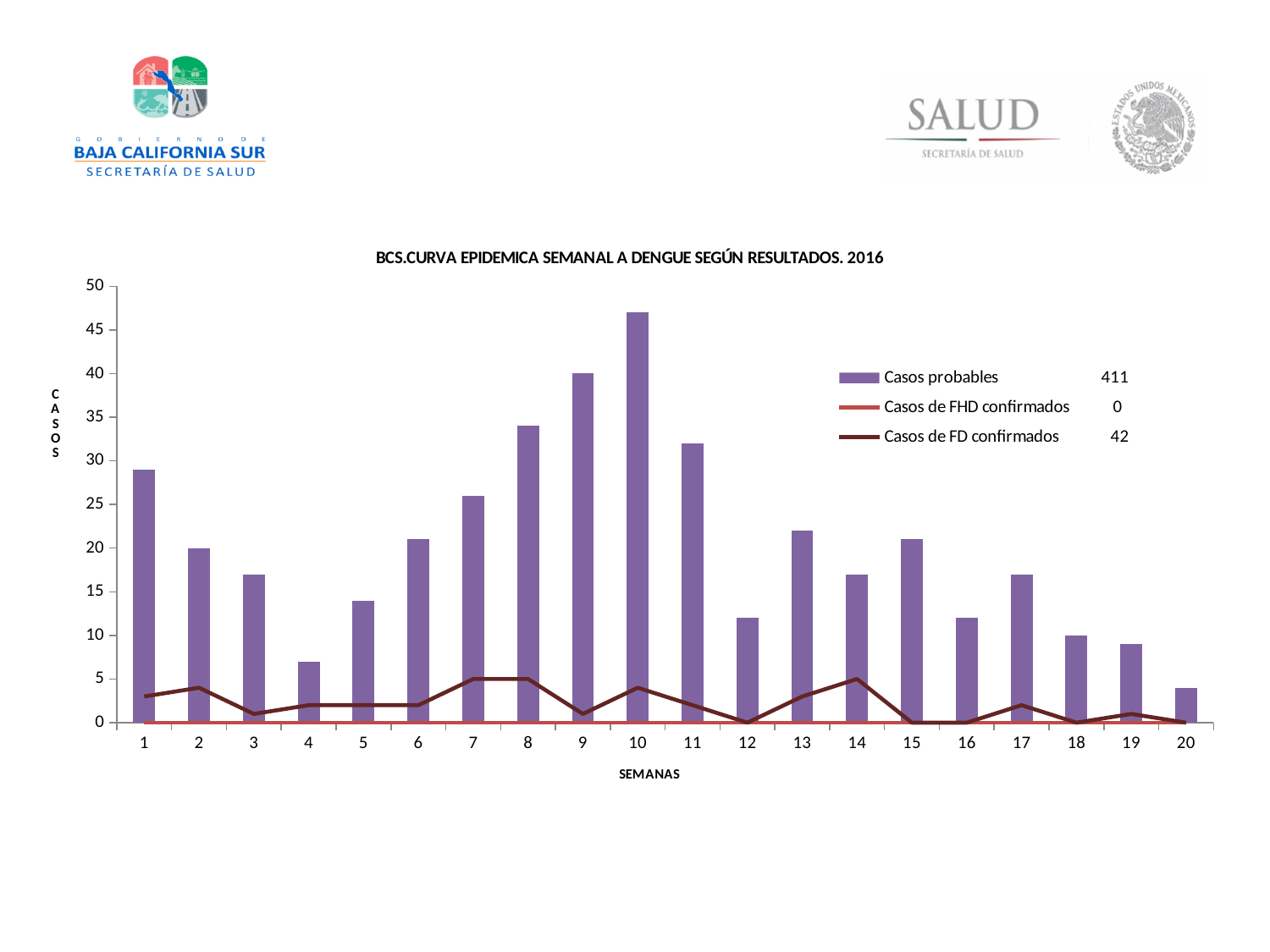
What total is shown in the legend for Casos de FHD confirmados? 0 How many series does the legend list? 3 How many weeks (semanas) are shown on the x axis? 20 In which week is the Casos probables bar lowest? 20 Which week has more Casos probables, week 9 or week 11? 9 In which week is the Casos probables bar highest? 10 What total is shown in the legend for Casos de FD confirmados? 42 Is the Casos probables value for week 1 greater or less than 30? less What is the title of the chart? BCS.CURVA EPIDEMICA SEMANAL A DENGUE SEGÚN RESULTADOS. 2016 Is the Casos probables value for week 10 greater or less than 45? greater Do the Casos probables bars rise or fall from week 10 to week 12? fall What total is shown in the legend for Casos probables? 411